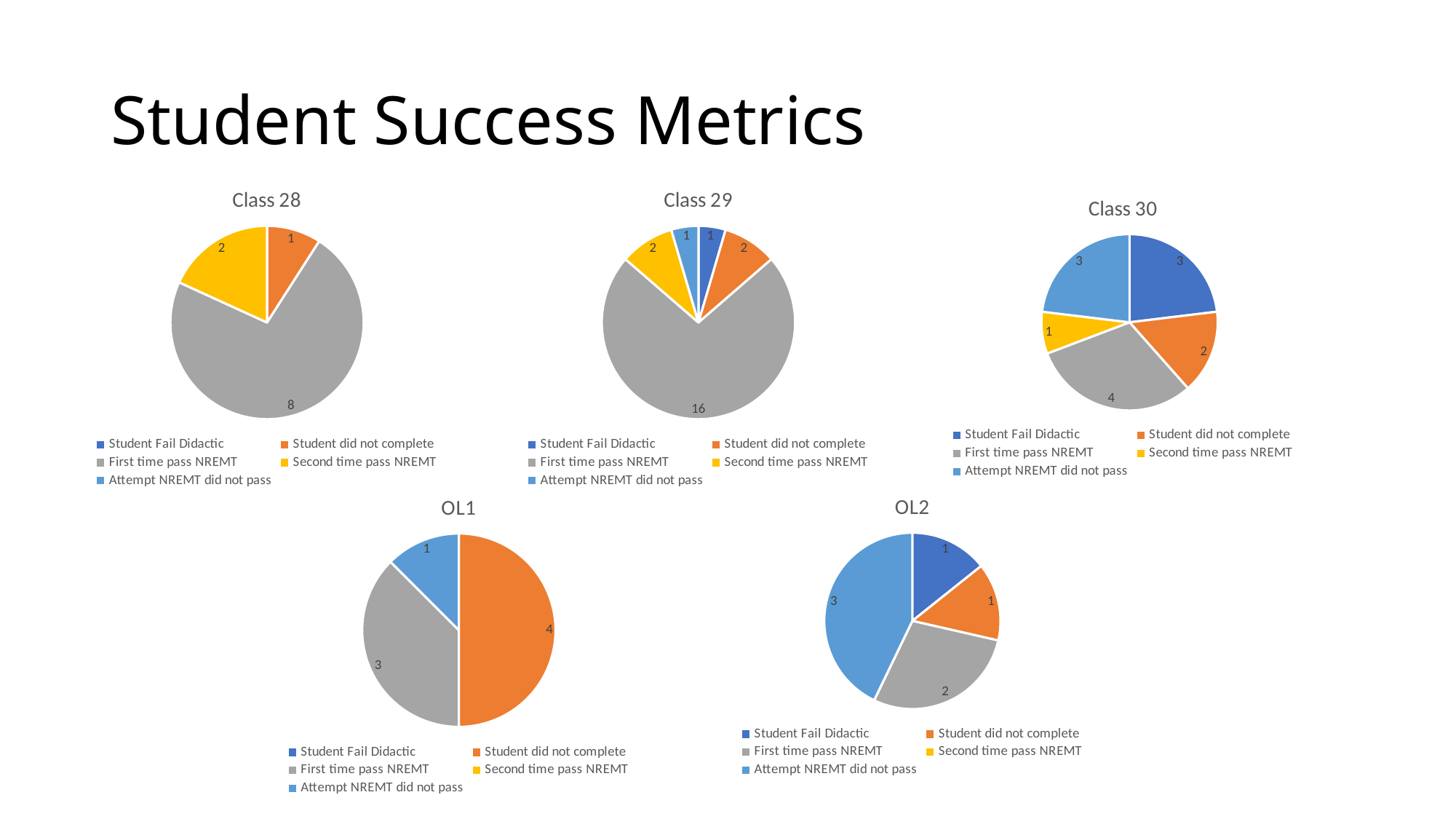
In the Class 29 chart, what is the difference between First time pass NREMT and Second time pass NREMT? 14 In the Class 30 chart, what is the value for Second time pass NREMT? 1 In the Class 30 chart, which is larger: First time pass NREMT or Student did not complete? First time pass NREMT What kind of chart is the Class 29 chart? Pie chart How many slices does the OL1 chart have? 3 In the OL2 chart, which category has the largest slice? Attempt NREMT did not pass How many entries does the legend of the Class 28 chart list? 5 In the OL1 chart, what share of the total does Student did not complete represent? 50% In the Class 29 chart, what is the value for First time pass NREMT? 16 In the OL1 chart, what is the value for Student did not complete? 4 In the Class 30 chart, which category has the smallest slice? Second time pass NREMT In the Class 28 chart, what is the value for First time pass NREMT? 8